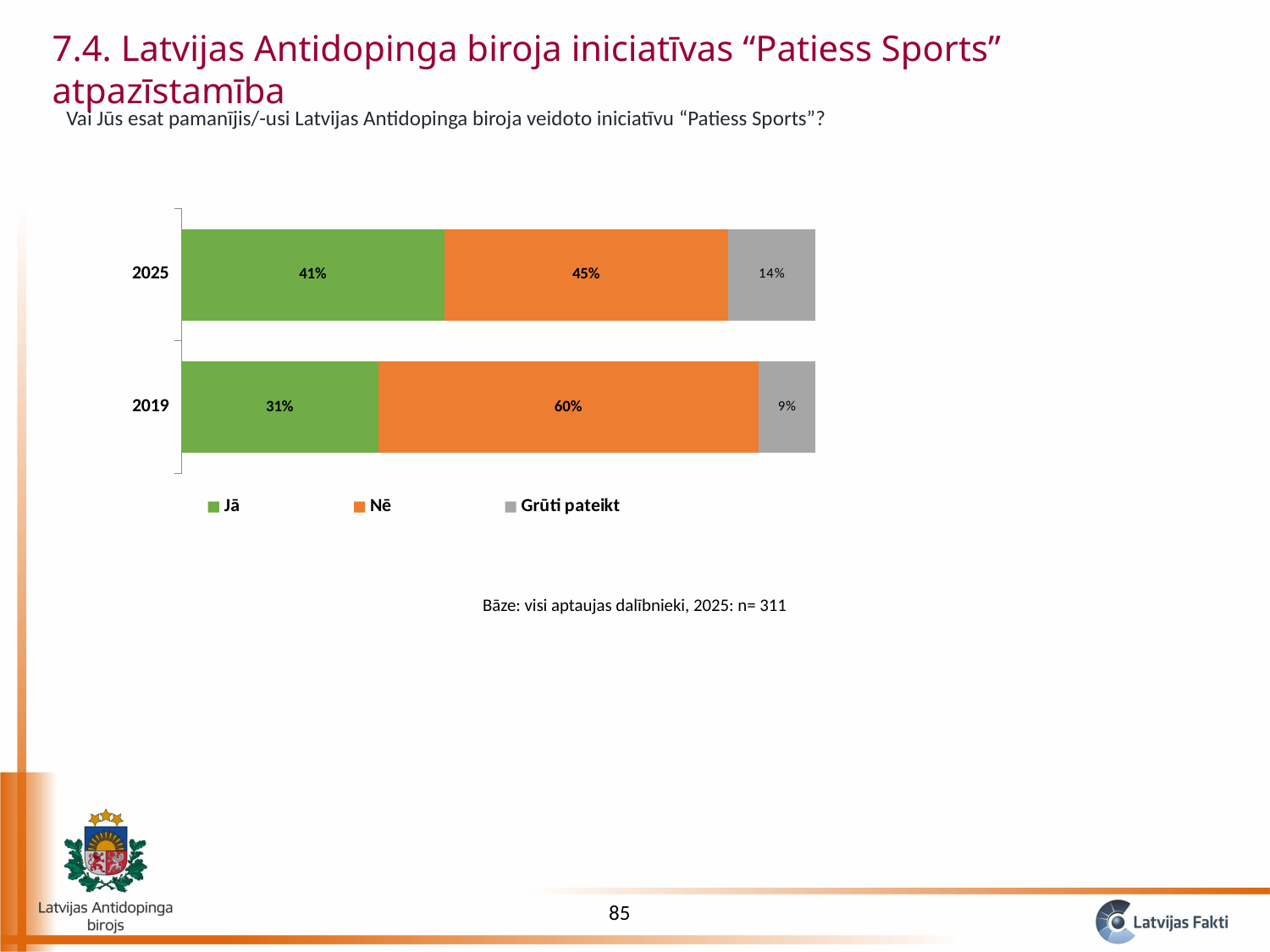
How many years (categories) are shown in the chart? 2 What percentage answered "Nē" in 2019? 60% What percentage answered "Jā" in 2019? 31% Which year has the lower share of "Grūti pateikt" answers? 2019 Which year has the higher share of "Nē" answers? 2019 Is the "Jā" share larger in 2025 or in 2019? 2025 By how many percentage points did the "Jā" share change from 2019 to 2025? 10 percentage points What percentage answered "Grūti pateikt" in 2025? 14% What percentage answered "Jā" in 2025? 41% How many series does the legend list? 3 What type of chart is shown on the slide? Stacked horizontal bar chart What is the difference between the "Nē" share in 2019 and in 2025? 15 percentage points